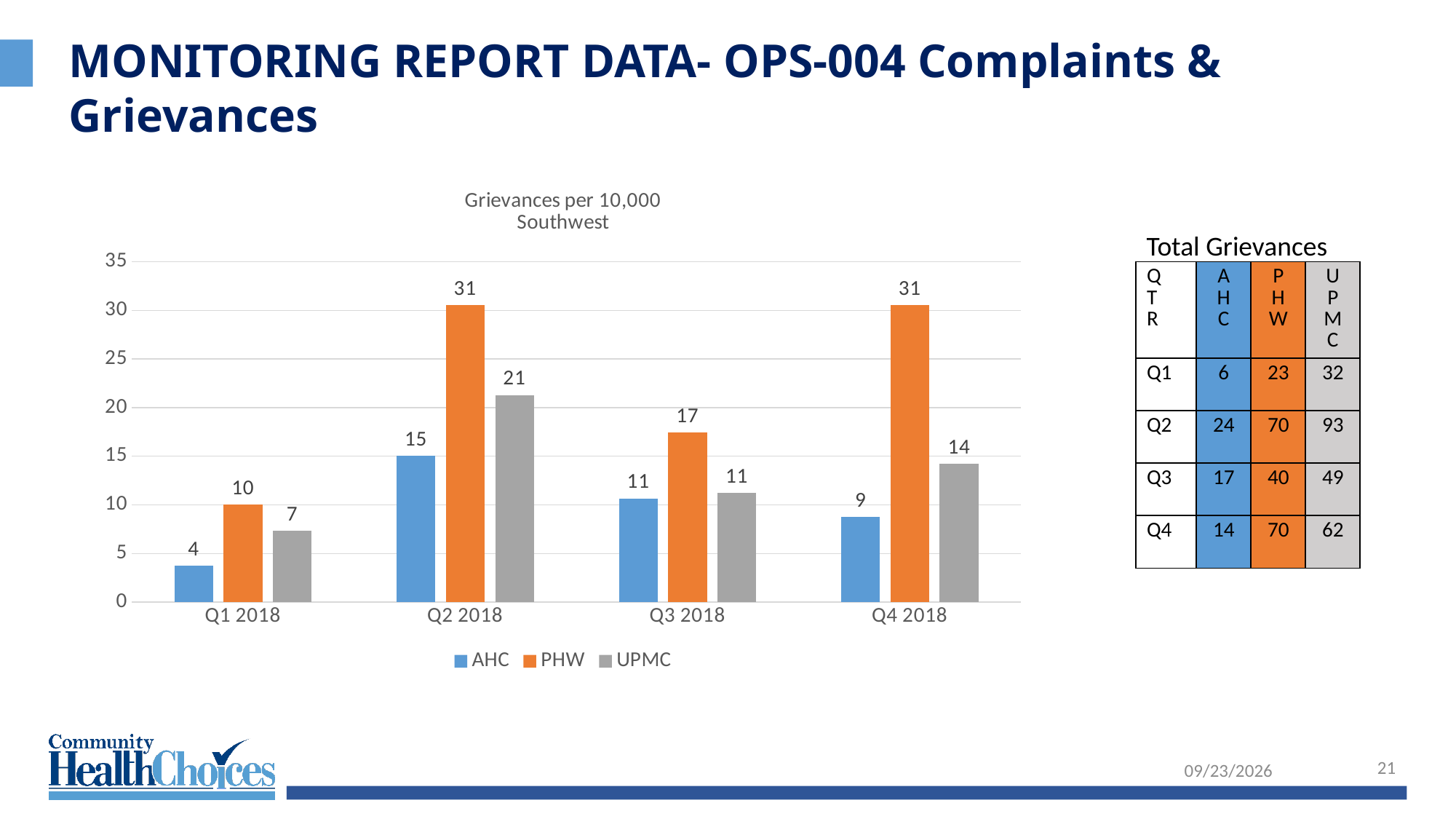
Which quarter has the lowest AHC value in the Grievances per 10,000 Southwest chart? Q1 2018 Is the value for PHW in Q4 2018 greater or less than 25 in the Grievances per 10,000 Southwest chart? greater What is the difference between the PHW and AHC values in Q2 2018 in the Grievances per 10,000 Southwest chart? 16 What is the value for UPMC in Q4 2018 in the Grievances per 10,000 Southwest chart? 14 What is the value for AHC in Q1 2018 in the Grievances per 10,000 Southwest chart? 4 Which series has the highest value in Q3 2018 in the Grievances per 10,000 Southwest chart? PHW Which colour represents PHW in the Grievances per 10,000 Southwest chart? orange How many quarters are shown on the x axis of the Grievances per 10,000 Southwest chart? 4 What is the value for PHW in Q2 2018 in the Grievances per 10,000 Southwest chart? 31 What kind of chart is the Grievances per 10,000 Southwest chart? bar chart In the Grievances per 10,000 Southwest chart, is the UPMC value in Q2 2018 larger or smaller than the UPMC value in Q3 2018? larger How many series does the legend of the Grievances per 10,000 Southwest chart list? 3